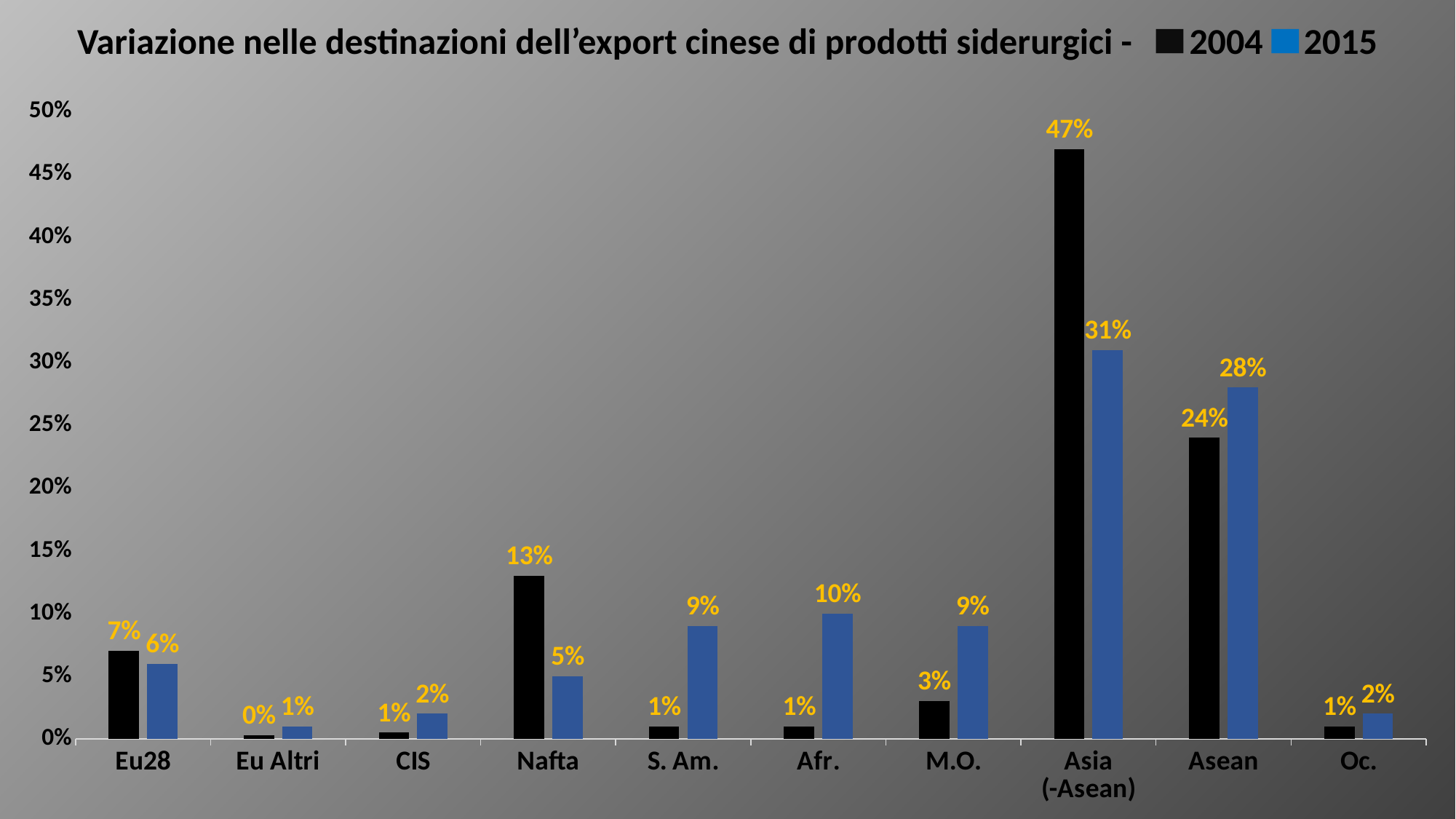
Which category has the lowest 2004 value? Eu Altri What is the difference between the 2004 and 2015 values for Nafta? 8% Which colour represents the 2015 series? Blue Which is larger for Asean, the 2004 value or the 2015 value? 2015 Which category has the highest 2004 value? Asia (-Asean) What kind of chart is shown on the slide? Bar chart How many series does the legend list? 2 What is the 2015 value for Asean? 28% What is the 2004 value for Asia (-Asean)? 47% How many categories are shown on the x axis? 10 What is the 2015 value for Afr.? 10% What is the difference between the 2004 and 2015 values for Asia (-Asean)? 16%